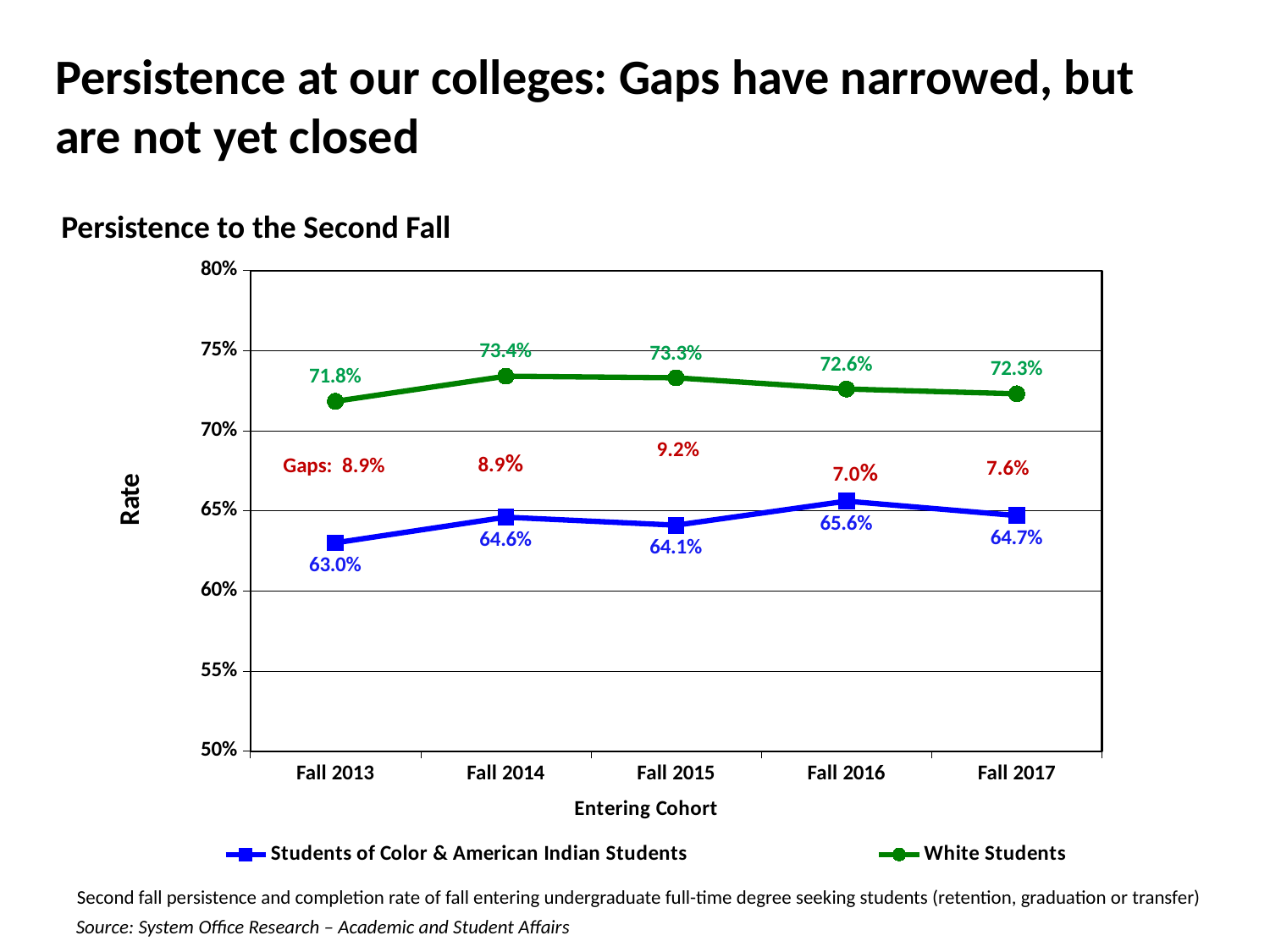
What is the persistence rate for Students of Color & American Indian Students in the Fall 2017 cohort? 64.7% What is the difference between the White Students rate and the Students of Color & American Indian Students rate for the Fall 2016 cohort? 7.0% What is the label of the y axis? Rate How many series does the legend list? 2 Which is larger: the Students of Color & American Indian Students rate for Fall 2014 or for Fall 2015? Fall 2014 Which entering cohort has the highest persistence rate for Students of Color & American Indian Students? Fall 2016 What is the persistence rate for Students of Color & American Indian Students in the Fall 2013 cohort? 63.0% How many entering cohorts are shown on the x axis? 5 What kind of chart is shown on the slide? Line chart Which entering cohort has the lowest persistence rate for White Students? Fall 2013 What is the persistence rate for White Students in the Fall 2014 cohort? 73.4% Is the White Students rate for the Fall 2013 cohort greater or less than 70%? greater